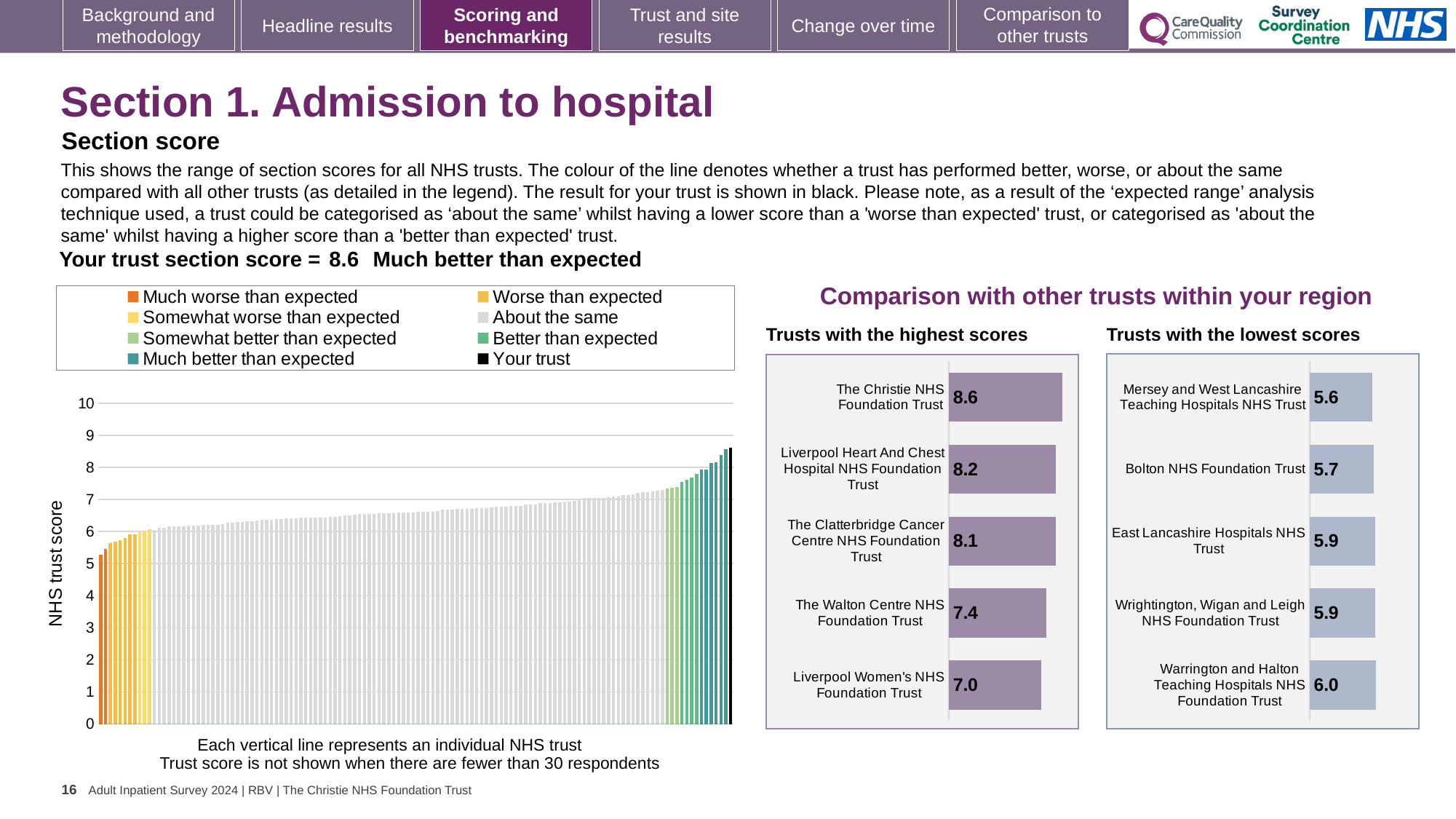
How many entries does the legend of the NHS trust score chart on the left list? 8 In the NHS trust score chart on the left, do the bar values rise or fall from left to right? rise In the NHS trust score chart on the left, is the value for the black 'Your trust' bar greater or less than 8? greater In the 'Trusts with the highest scores' chart, what is the difference between the scores of The Christie NHS Foundation Trust and Liverpool Heart And Chest Hospital NHS Foundation Trust? 0.4 In the 'Trusts with the lowest scores' chart, what is the difference between the scores of Warrington and Halton Teaching Hospitals NHS Foundation Trust and Mersey and West Lancashire Teaching Hospitals NHS Trust? 0.4 In the 'Trusts with the lowest scores' chart, what is the score for Bolton NHS Foundation Trust? 5.7 In the 'Trusts with the highest scores' chart, which trust has the lowest score shown? Liverpool Women's NHS Foundation Trust In the 'Trusts with the lowest scores' chart, which trust has the lowest score? Mersey and West Lancashire Teaching Hospitals NHS Trust In the 'Trusts with the highest scores' chart, what is the score for The Walton Centre NHS Foundation Trust? 7.4 How many trusts are shown in the 'Trusts with the lowest scores' chart? 5 In the 'Trusts with the highest scores' chart, what is the score for The Christie NHS Foundation Trust? 8.6 In the 'Trusts with the highest scores' chart, which has the higher score: The Clatterbridge Cancer Centre NHS Foundation Trust or The Walton Centre NHS Foundation Trust? The Clatterbridge Cancer Centre NHS Foundation Trust